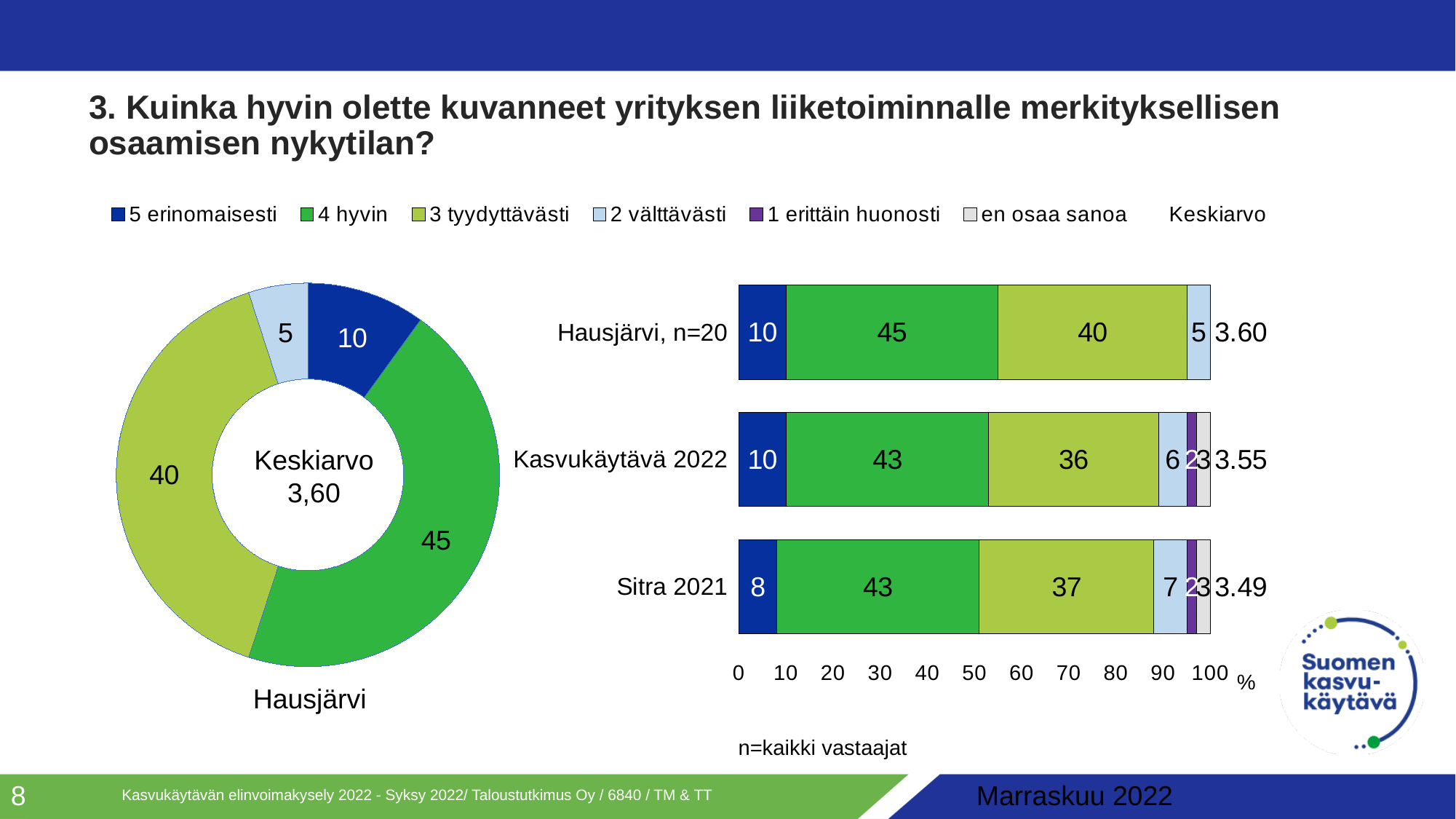
In the stacked bar chart, which row has the lowest '5 erinomaisesti' share? Sitra 2021 What average value (Keskiarvo) is printed in the centre of the donut chart? 3,60 In the stacked bar chart, what percentage of Hausjärvi, n=20 respondents answered '4 hyvin'? 45 In the stacked bar chart, what is the difference between the '3 tyydyttävästi' share for Hausjärvi, n=20 and for Kasvukäytävä 2022? 4 What type of chart is shown on the left side of the slide? Donut chart In the donut chart for Hausjärvi, what is the value of the '2 välttävästi' slice? 5 In the stacked bar chart, which is larger: the '2 välttävästi' share for Sitra 2021 or for Hausjärvi, n=20? Sitra 2021 In the stacked bar chart, which row has the highest Keskiarvo value? Hausjärvi, n=20 How many rows (categories) does the stacked bar chart show? 3 In the stacked bar chart, what is the Keskiarvo (average) shown for Sitra 2021? 3.49 In the stacked bar chart, what percentage of Kasvukäytävä 2022 respondents answered '3 tyydyttävästi'? 36 How many entries does the legend list, including Keskiarvo? 7